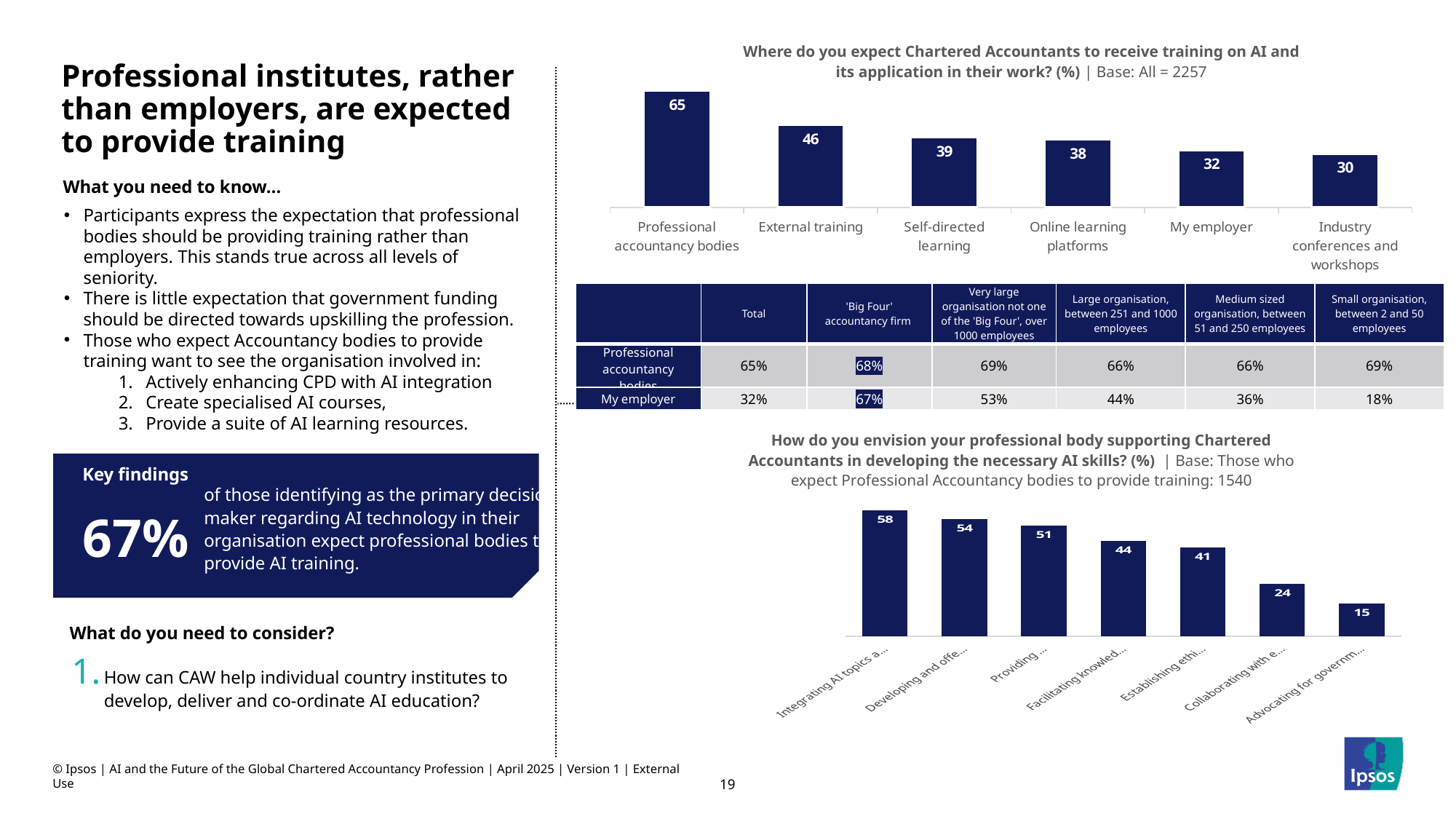
In the bottom chart on how the professional body should support AI skills development, do the values rise or fall from left to right? Fall In the top chart on where Chartered Accountants are expected to receive AI training, what is the value for My employer? 32 In the bottom chart on how the professional body should support AI skills development, what is the lowest value shown? 15 What kind of chart is the top chart on where Chartered Accountants are expected to receive AI training? Bar chart In the top chart on where Chartered Accountants are expected to receive AI training, what is the difference between External training and Self-directed learning? 7 In the bottom chart on how the professional body should support AI skills development, what is the value of the leftmost bar? 58 How many bars are shown in the bottom chart on how the professional body should support AI skills development? 7 How many categories are shown in the top chart on where Chartered Accountants are expected to receive AI training? 6 In the top chart on where Chartered Accountants are expected to receive AI training, which category has the lowest value? Industry conferences and workshops In the top chart on where Chartered Accountants are expected to receive AI training, which category has the highest value? Professional accountancy bodies In the top chart on where Chartered Accountants are expected to receive AI training, what is the value for Professional accountancy bodies? 65 In the top chart on where Chartered Accountants are expected to receive AI training, which is larger: Online learning platforms or My employer? Online learning platforms